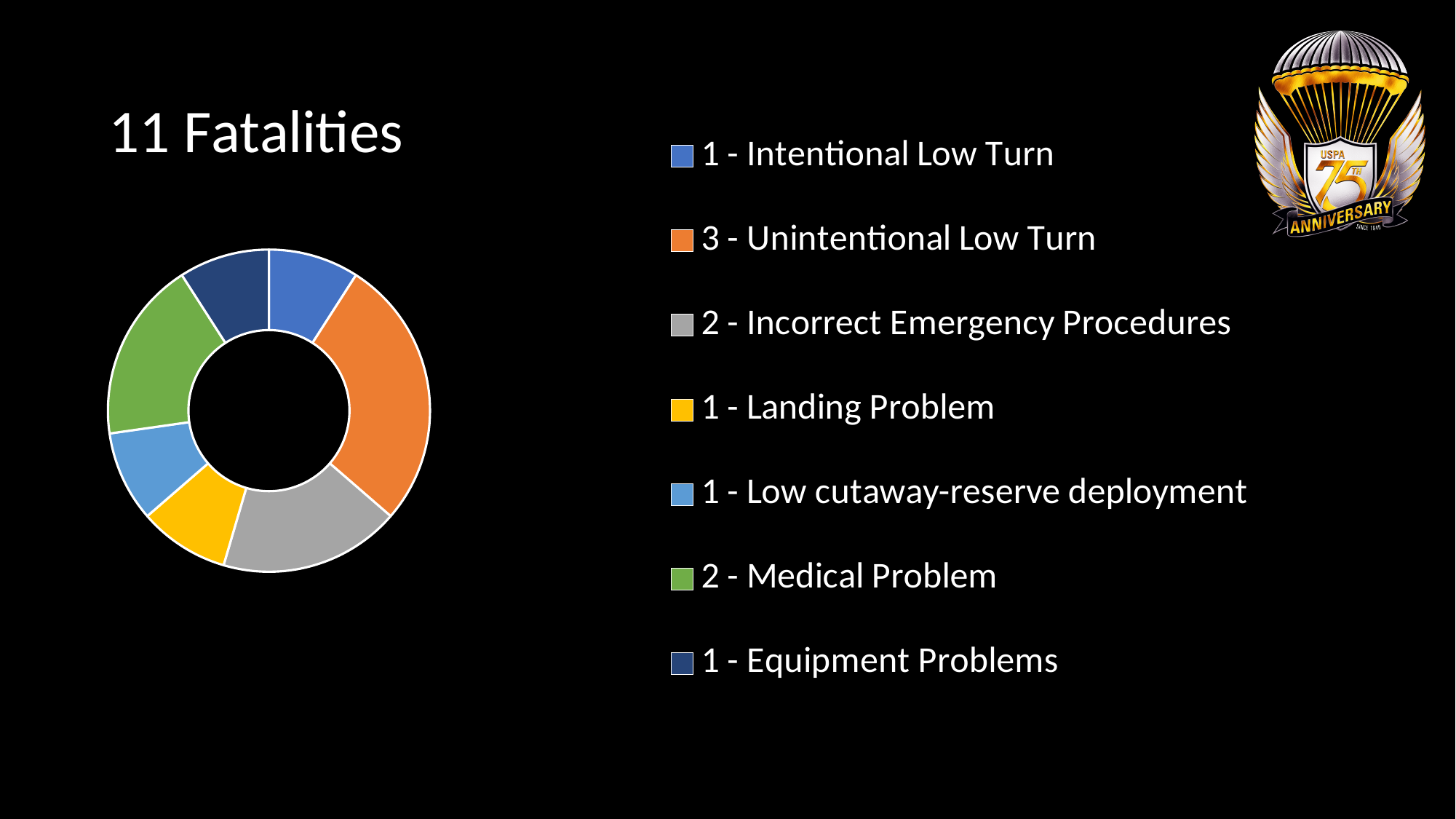
Which colour represents Equipment Problems in the chart? Dark blue How many fatalities are attributed to Incorrect Emergency Procedures? 2 What is the difference between the number of Unintentional Low Turn fatalities and Intentional Low Turn fatalities? 2 Which category accounts for the most fatalities? Unintentional Low Turn How many categories does the chart show? 7 How many fatalities are attributed to Low cutaway-reserve deployment? 1 What type of chart is shown on the slide? Doughnut (pie) chart What is the total number of fatalities shown in the chart? 11 How many fatalities are attributed to Unintentional Low Turn? 3 How many fatalities are attributed to Medical Problem? 2 What is the title of the slide? 11 Fatalities Which has more fatalities, Medical Problem or Landing Problem? Medical Problem